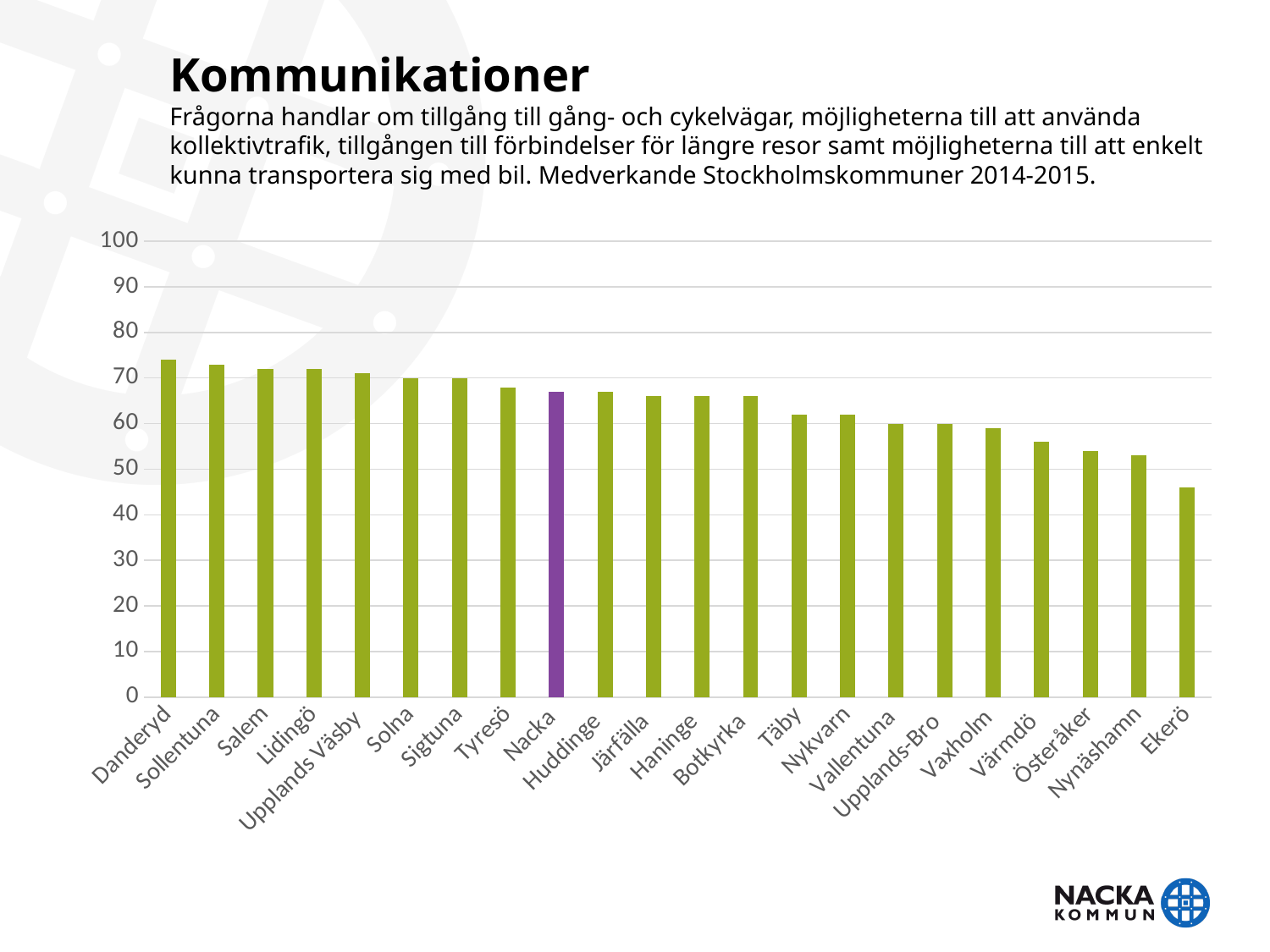
Is the value for Ekerö greater or less than 50? less Which municipality's bar is shown in a different colour (purple) from the others? Nacka Which has a larger value, Salem or Värmdö? Salem Is the value for Tyresö greater or less than 70? less Which municipality has the lowest value in the chart? Ekerö Which has a larger value, Nacka or Ekerö? Nacka What kind of chart is shown on the slide? bar chart Is the value for Nacka greater or less than 60? greater How many municipalities (bars) are shown in the chart? 22 Do the values rise or fall from left to right along the x axis? fall